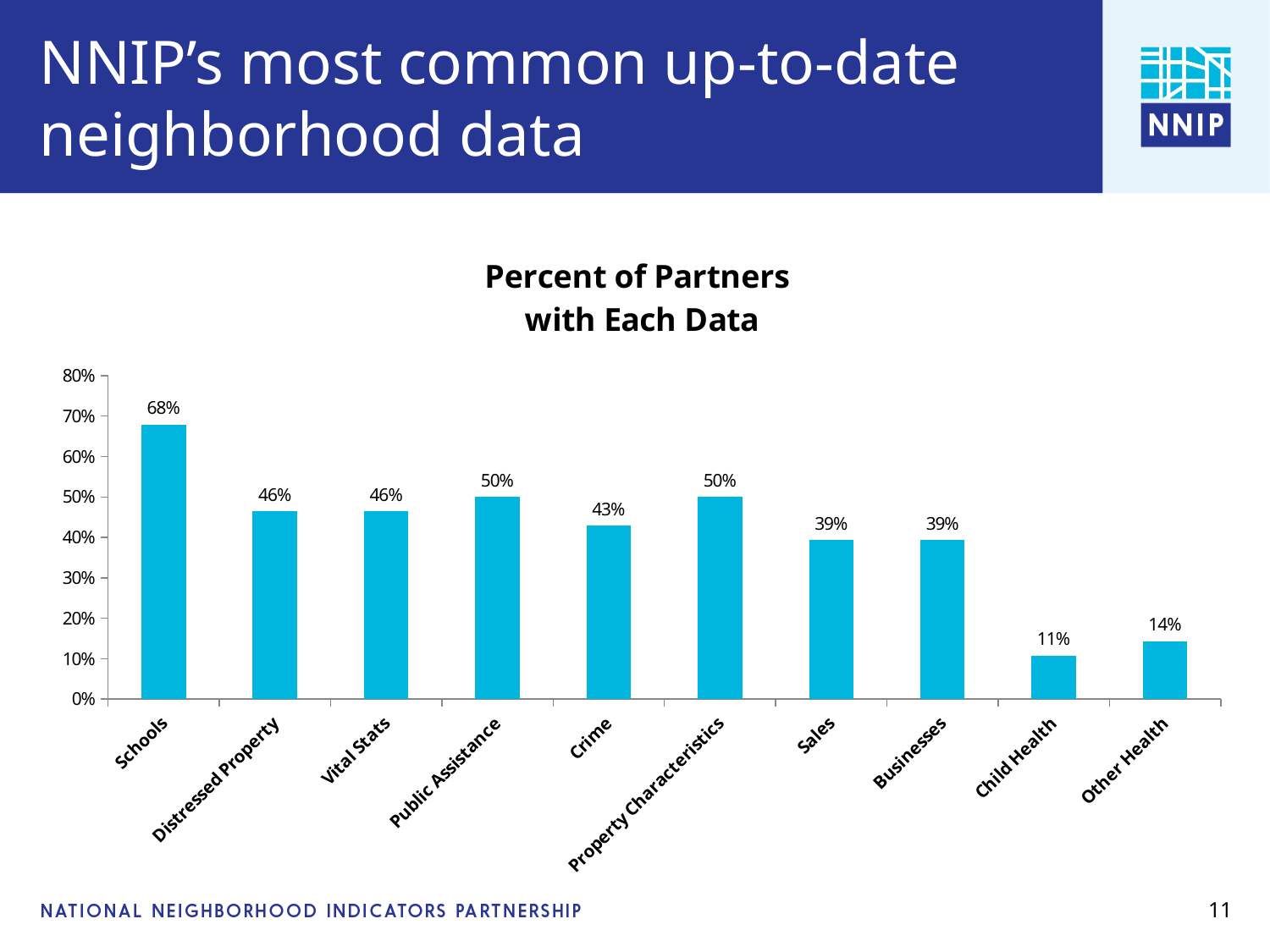
What percent of partners have Schools data? 68% What is the value for Child Health? 11% Is the value for Distressed Property greater or less than 40%? greater Which category has the highest percent of partners? Schools How many categories are shown on the x axis? 10 What kind of chart is shown on the slide? Bar chart Which category has the lowest percent of partners? Child Health What is the difference between the values for Schools and Public Assistance? 18% What is the title of the chart? Percent of Partners with Each Data What is the difference between the values for Other Health and Child Health? 3% Which is larger, the value for Crime or the value for Sales? Crime What is the value for Crime? 43%